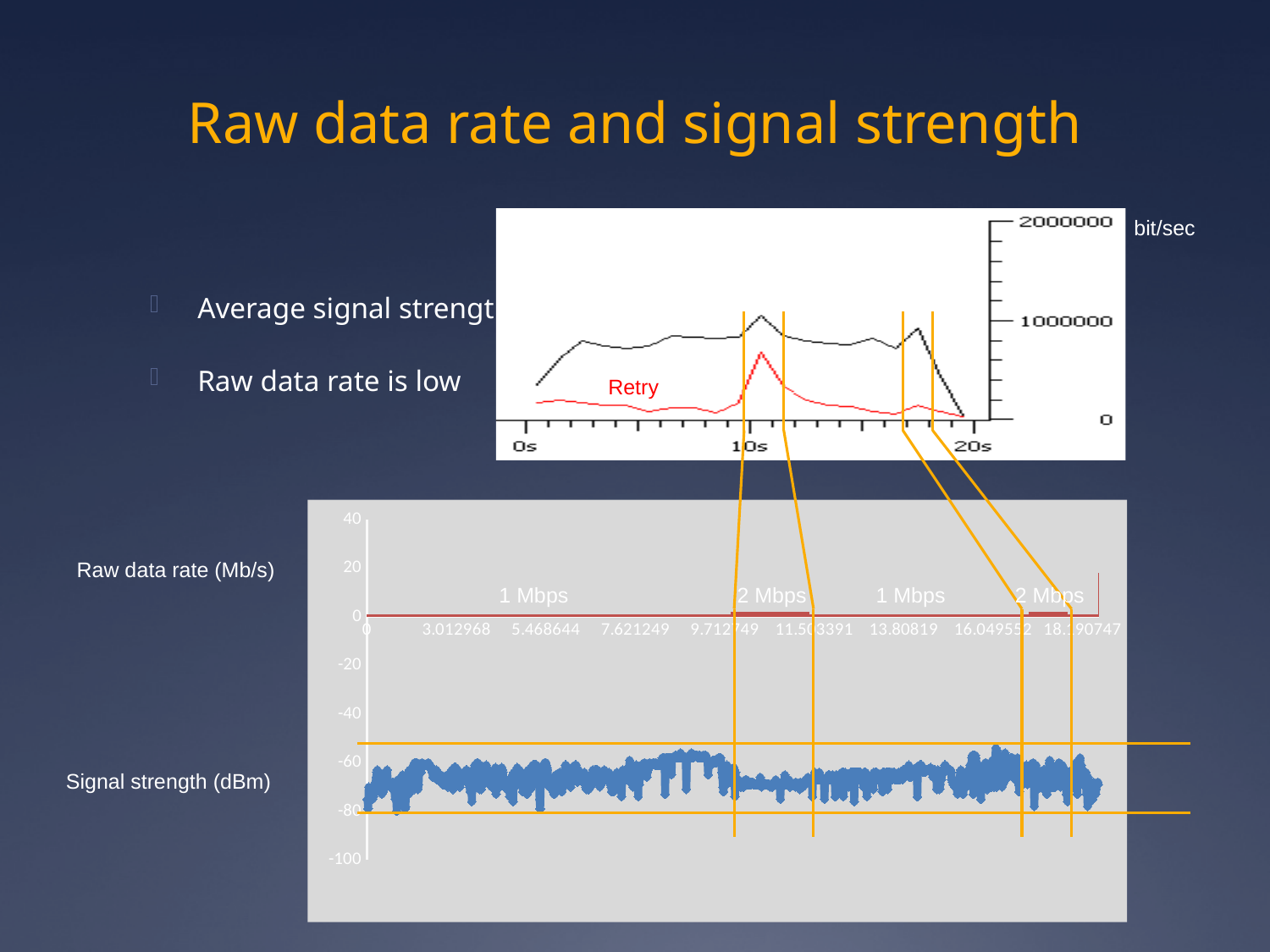
In the top chart, is the peak of the Retry line near 10s greater or less than 1000000 bit/sec? less In the top chart, what is the last time label on the x axis? 20s In the bottom chart, what is the raw data rate labelled for the segment between about 9.7 s and 11.5 s? 2 Mbps What label is given to the lower (blue) series of the bottom chart? Signal strength (dBm) In the top chart, is the black line at 5s greater or less than 1000000 bit/sec? less In the bottom chart, is the signal strength trace greater or less than -40 dBm? less In the bottom chart, what is the raw data rate labelled for the first segment (before about 9.7 s)? 1 Mbps What kind of chart is the top chart (bit/sec over time)? line chart In the top chart, what is the highest value shown on the bit/sec axis? 2000000 In the top chart, what label is given to the red line? Retry In the bottom chart, how many tick labels are printed along the x axis? 9